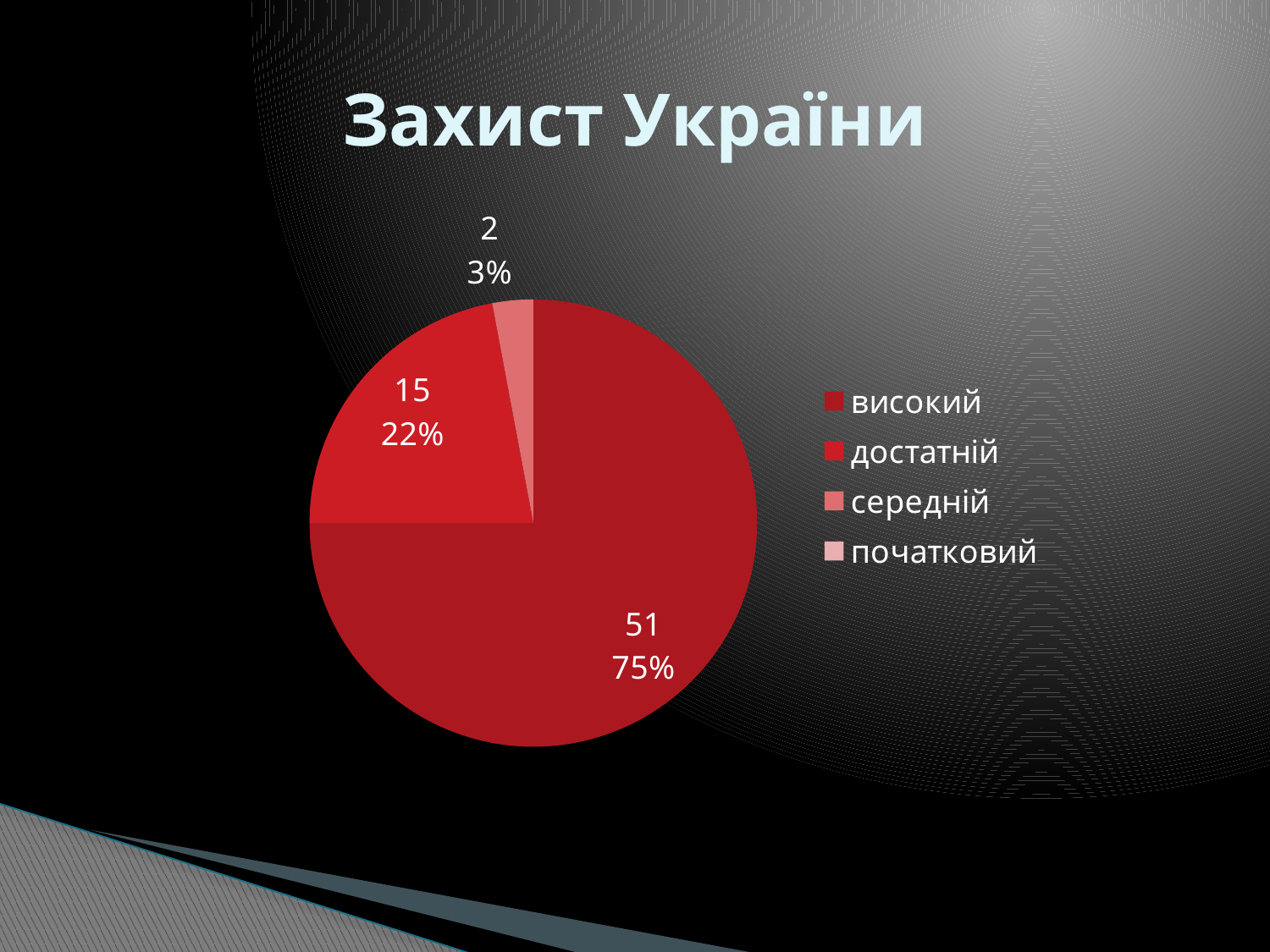
What value is shown for the достатній slice? 15 Which category has the largest slice? високий What percentage share does the середній slice have? 3% What value is shown for the середній slice? 2 What is the difference between the високий value and the достатній value? 36 What value is shown for the високий slice? 51 Which is larger, the достатній slice or the середній slice? достатній What percentage share does the достатній slice have? 22% How many entries does the legend list? 4 What kind of chart is shown on the slide? pie chart What is the title of the chart? Захист України What percentage share does the високий slice have? 75%